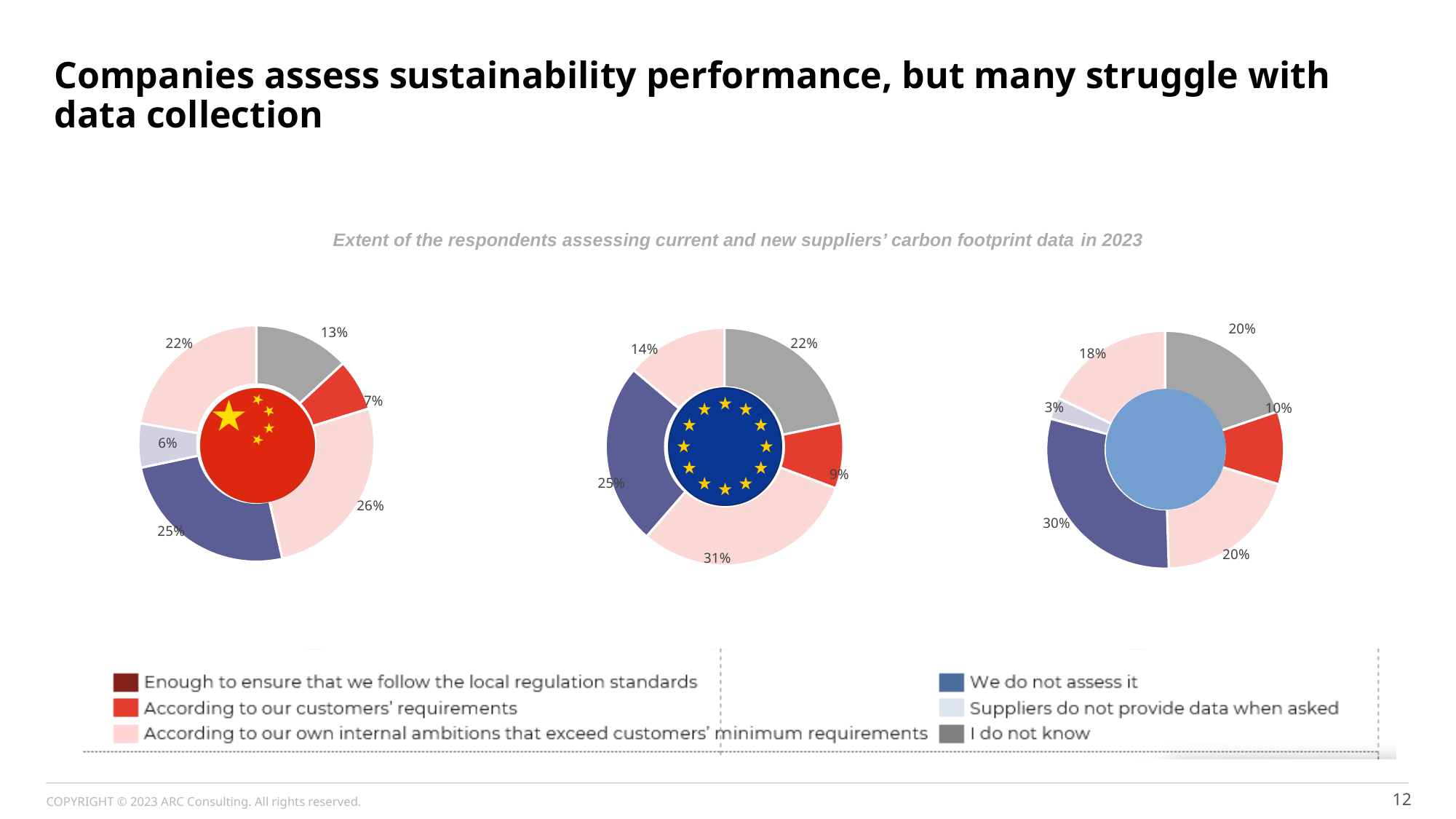
What is the largest percentage shown in the middle chart (EU flag)? 31% In the middle chart (EU flag), what percentage of respondents assess suppliers "According to our customers' requirements"? 9% In the middle chart (EU flag), what percentage of respondents answered "We do not assess it"? 25% What type of chart is used on this slide? Pie (donut) chart How many categories does the legend list? 6 In the left chart (China flag), what percentage of respondents answered "Suppliers do not provide data when asked"? 6% In the right chart, what percentage of respondents answered "Suppliers do not provide data when asked"? 3% Which chart shows a larger share for "We do not assess it": the left chart (China flag) or the right chart? The right chart